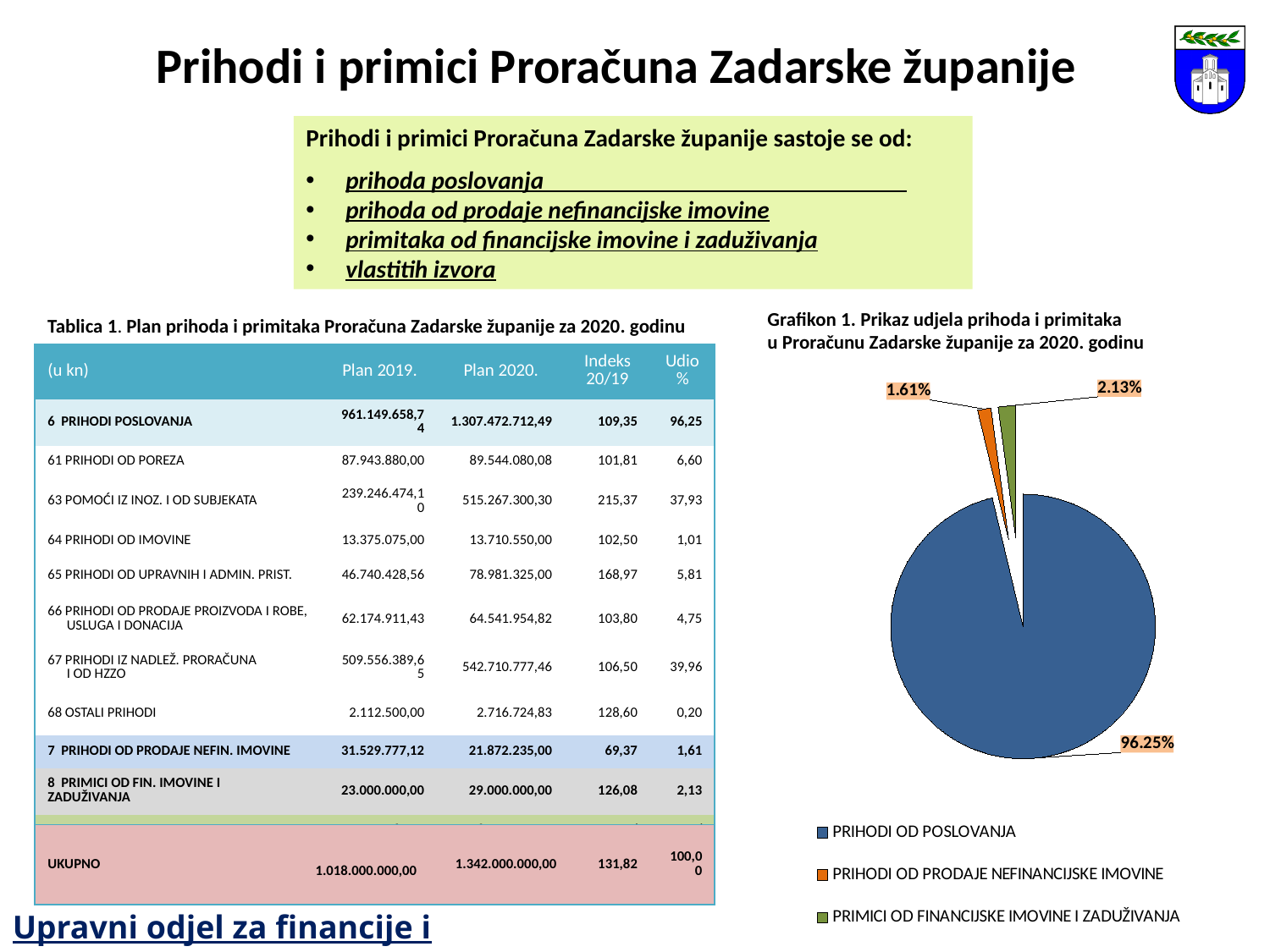
What share of the pie chart does PRIHODI OD POSLOVANJA have? 96.25% What colour is the PRIHODI OD POSLOVANJA slice in the pie chart? blue What type of chart is shown on the slide? pie chart What share of the pie chart does PRIHODI OD PRODAJE NEFINANCIJSKE IMOVINE have? 1.61% What is the difference in percentage points between the PRIMICI OD FINANCIJSKE IMOVINE I ZADUŽIVANJA slice and the PRIHODI OD PRODAJE NEFINANCIJSKE IMOVINE slice? 0.52% Which category has the smallest slice in the pie chart? PRIHODI OD PRODAJE NEFINANCIJSKE IMOVINE What share of the pie chart does PRIMICI OD FINANCIJSKE IMOVINE I ZADUŽIVANJA have? 2.13% How many slices does the pie chart have? 3 Which category has the largest slice in the pie chart? PRIHODI OD POSLOVANJA Which slice is larger: PRIMICI OD FINANCIJSKE IMOVINE I ZADUŽIVANJA or PRIHODI OD PRODAJE NEFINANCIJSKE IMOVINE? PRIMICI OD FINANCIJSKE IMOVINE I ZADUŽIVANJA How many entries does the pie chart's legend list? 3 What is the difference in percentage points between the PRIHODI OD POSLOVANJA slice and the PRIMICI OD FINANCIJSKE IMOVINE I ZADUŽIVANJA slice? 94.12%